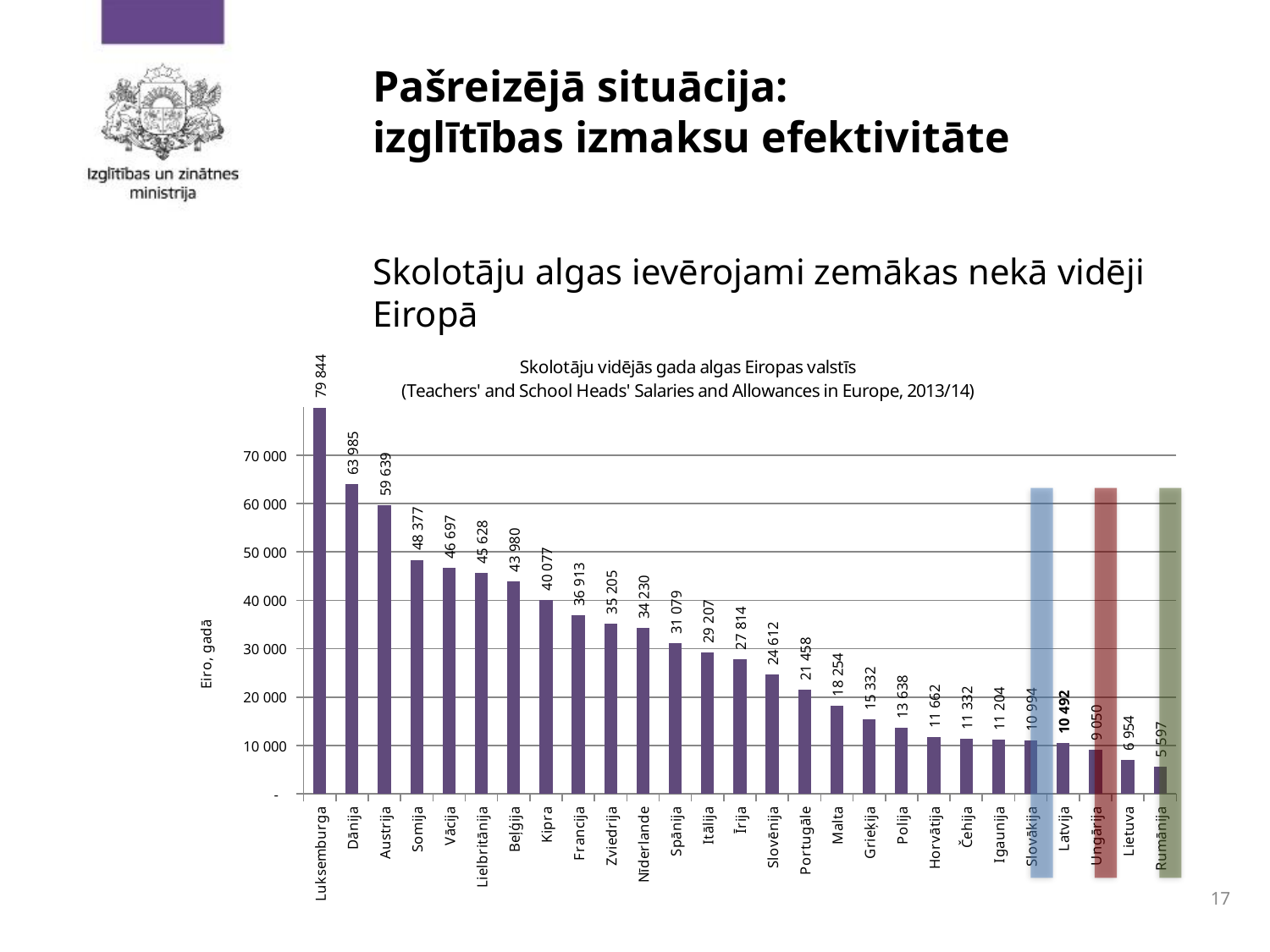
How many countries are shown on the chart? 27 What is the difference between the values for Dānija and Austrija? 4 346 What is the difference between the values for Igaunija and Latvija? 712 What is the value for Latvija? 10 492 What is the value for Somija? 48 377 Which country has the highest value? Luksemburga Is the value for Kipra greater or less than 40 000? greater What is the value for Luksemburga? 79 844 Which is larger, the value for Francija or the value for Zviedrija? Francija What kind of chart is shown on the slide? bar chart What is the label of the vertical axis? Eiro, gadā Which country has the lowest value? Rumānija